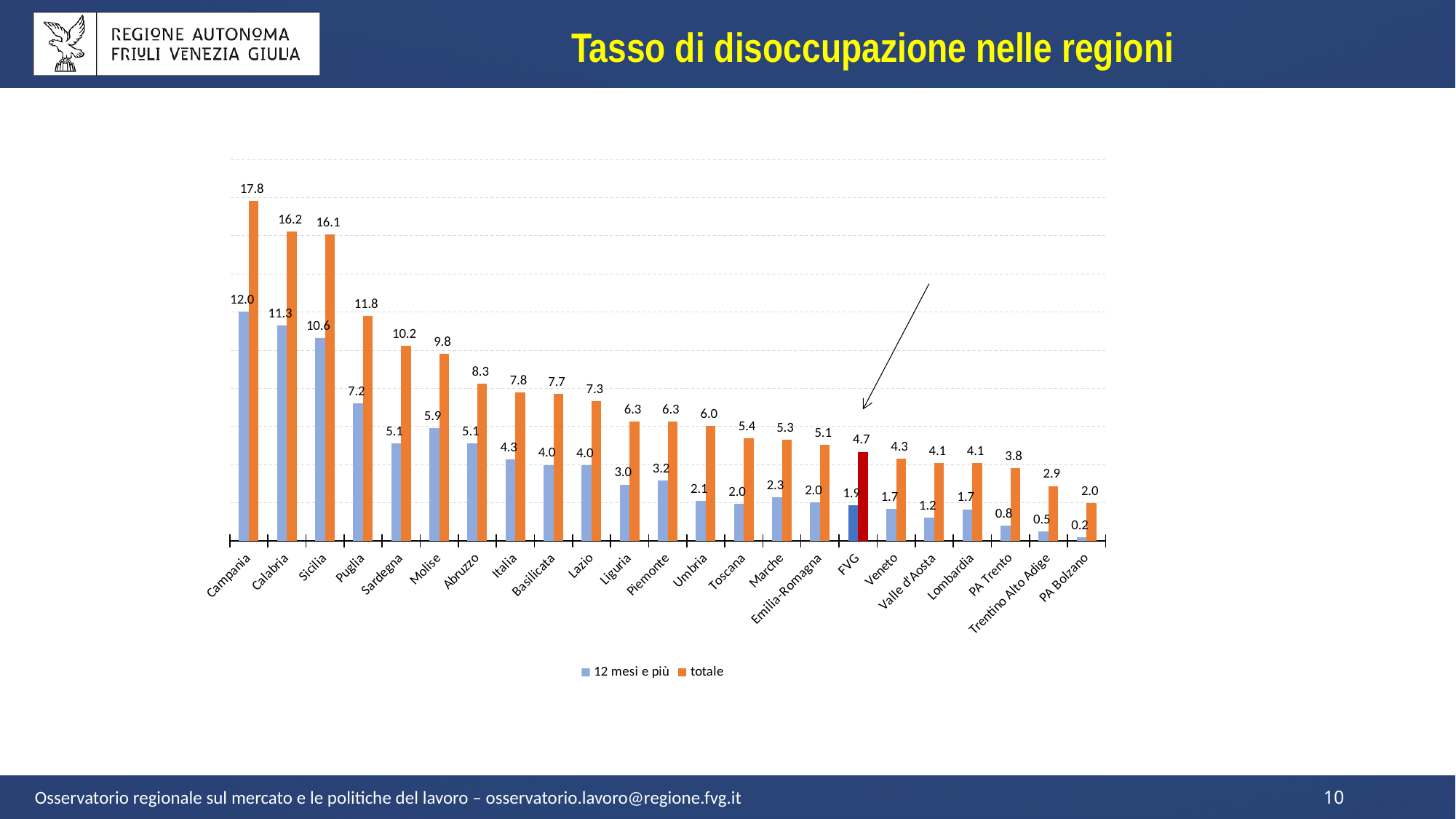
What is the 'totale' value for Campania? 17.8 How many regions/categories are shown on the x axis? 23 Which has a larger '12 mesi e più' value, Molise or Abruzzo? Molise Which region has the highest 'totale' value? Campania What kind of chart is shown on the slide? Bar chart What is the '12 mesi e più' value for FVG? 1.9 Which has a larger 'totale' value, Puglia or Sardegna? Puglia What is the difference between the 'totale' and '12 mesi e più' values for FVG? 2.8 What is the 'totale' value for Italia? 7.8 Which region has the lowest '12 mesi e più' value? PA Bolzano How many series does the legend list? 2 What is the difference between the 'totale' values for Campania and Calabria? 1.6